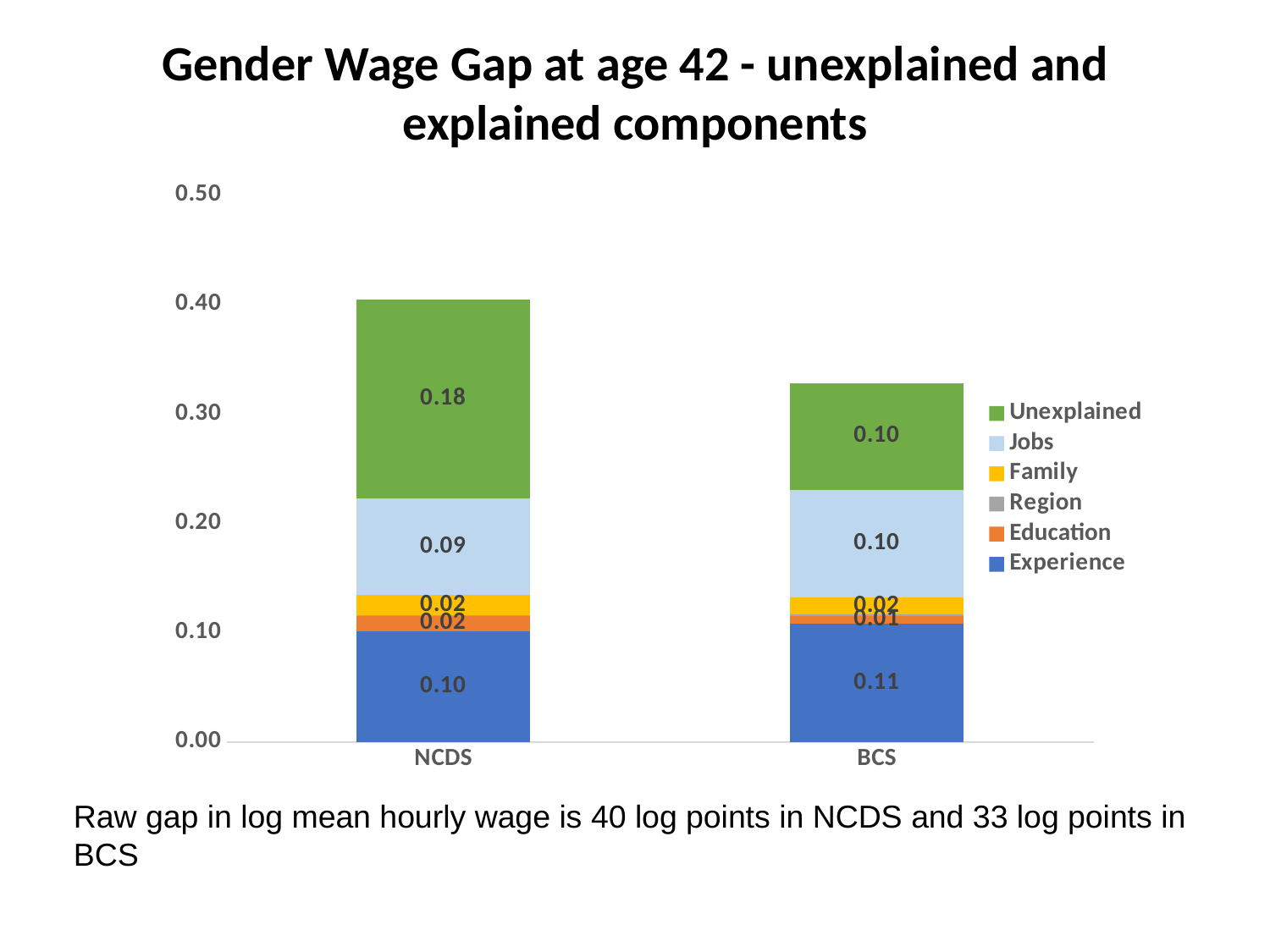
What is the value of the Education component for NCDS? 0.02 Is the total height of the NCDS bar greater or less than 0.30? greater Which component is the largest in the NCDS bar? Unexplained How many series does the legend list? 6 What is the value of the Jobs component for BCS? 0.10 Which is larger, the Jobs component for NCDS or for BCS? BCS What is the value of the Unexplained component for NCDS? 0.18 How many categories are shown on the x axis? 2 What is the difference between the Unexplained component for NCDS and for BCS? 0.08 What is the value of the Experience component for BCS? 0.11 Is the total height of the BCS bar greater or less than 0.40? less What kind of chart is shown on the slide? Stacked bar chart